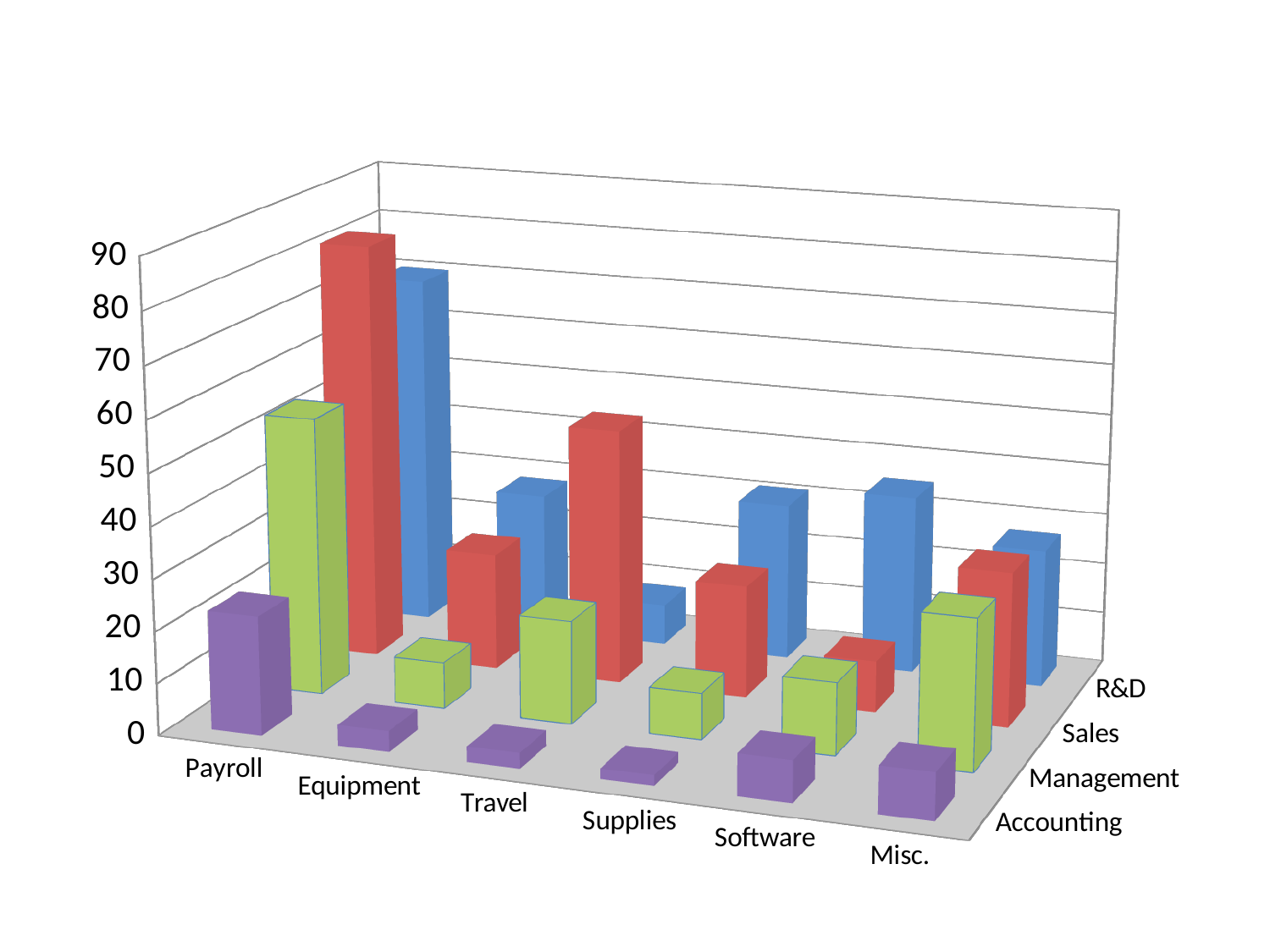
Is the Accounting value for Equipment greater or less than 20? less What colour are the bars for the Accounting series? purple Is the R&D value for Payroll greater or less than 50? greater Which category has the highest Sales value? Payroll Which is larger, the Sales value for Travel or the Sales value for Software? Travel What kind of chart is shown on the slide? bar chart Which category has the highest Accounting value? Payroll Which category has the highest Management value? Payroll How many expense categories are shown along the x axis? 6 How many series (departments) does the chart show? 4 Which is larger, the Management value for Payroll or the Management value for Equipment? Payroll Is the Sales value for Payroll greater or less than 50? greater